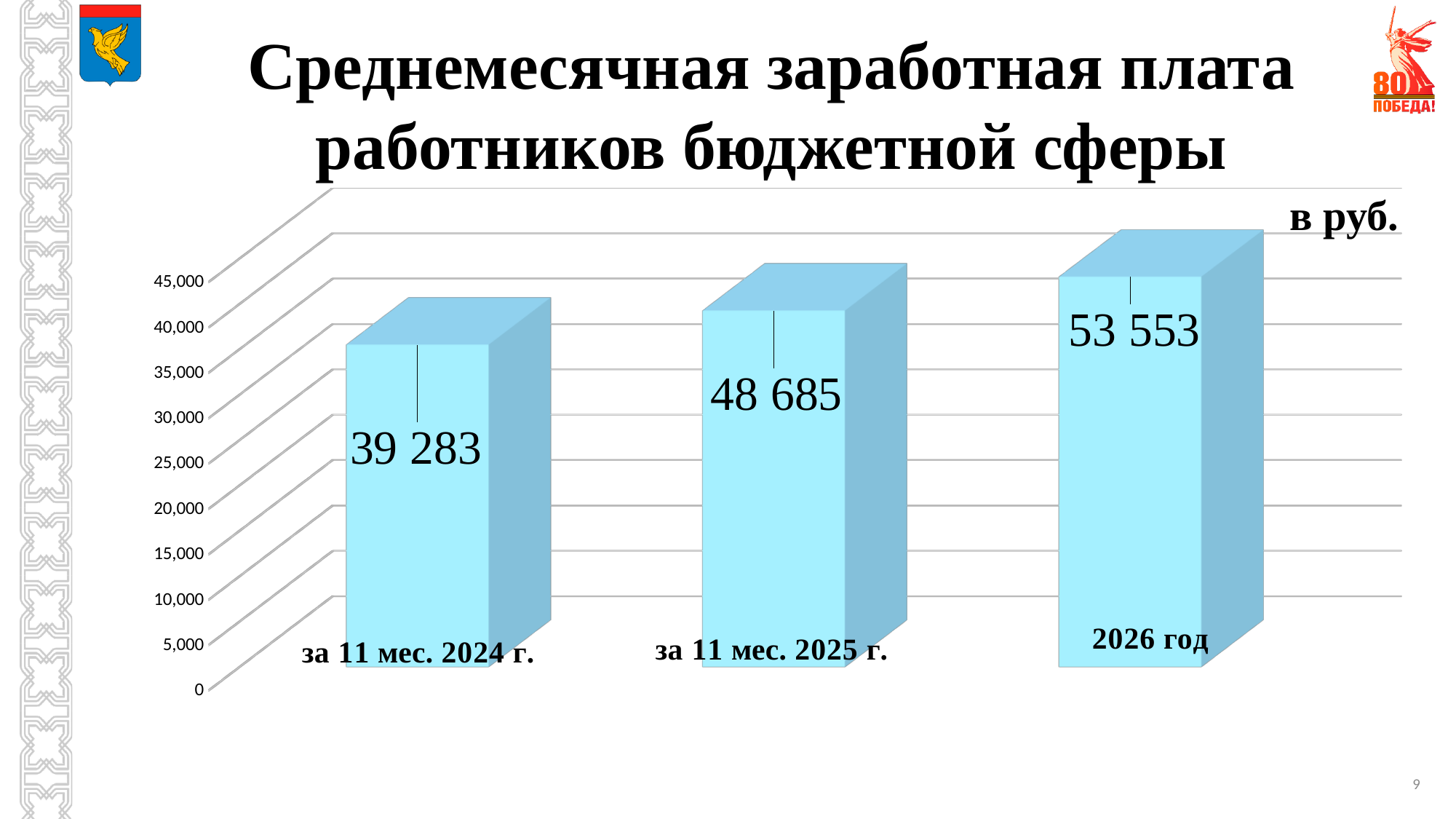
Which is larger: the salary for 11 months of 2024 or the salary for 11 months of 2025? за 11 мес. 2025 г. What is the difference between the salary for 2026 год and the salary for 11 months of 2025? 4 868 Do the values rise or fall from left to right across the periods? rise What kind of chart is shown on the slide? bar chart Which period has the lowest average monthly salary? за 11 мес. 2024 г. What is the difference between the salary for 11 months of 2025 and the salary for 11 months of 2024? 9 402 What is the average monthly salary for 11 months of 2024 (за 11 мес. 2024 г.)? 39 283 How many periods (bars) are shown in the chart? 3 What is the average monthly salary for 11 months of 2025 (за 11 мес. 2025 г.)? 48 685 What unit is indicated for the values in the chart? в руб. Which period has the highest average monthly salary? 2026 год What is the average monthly salary shown for 2026 год? 53 553